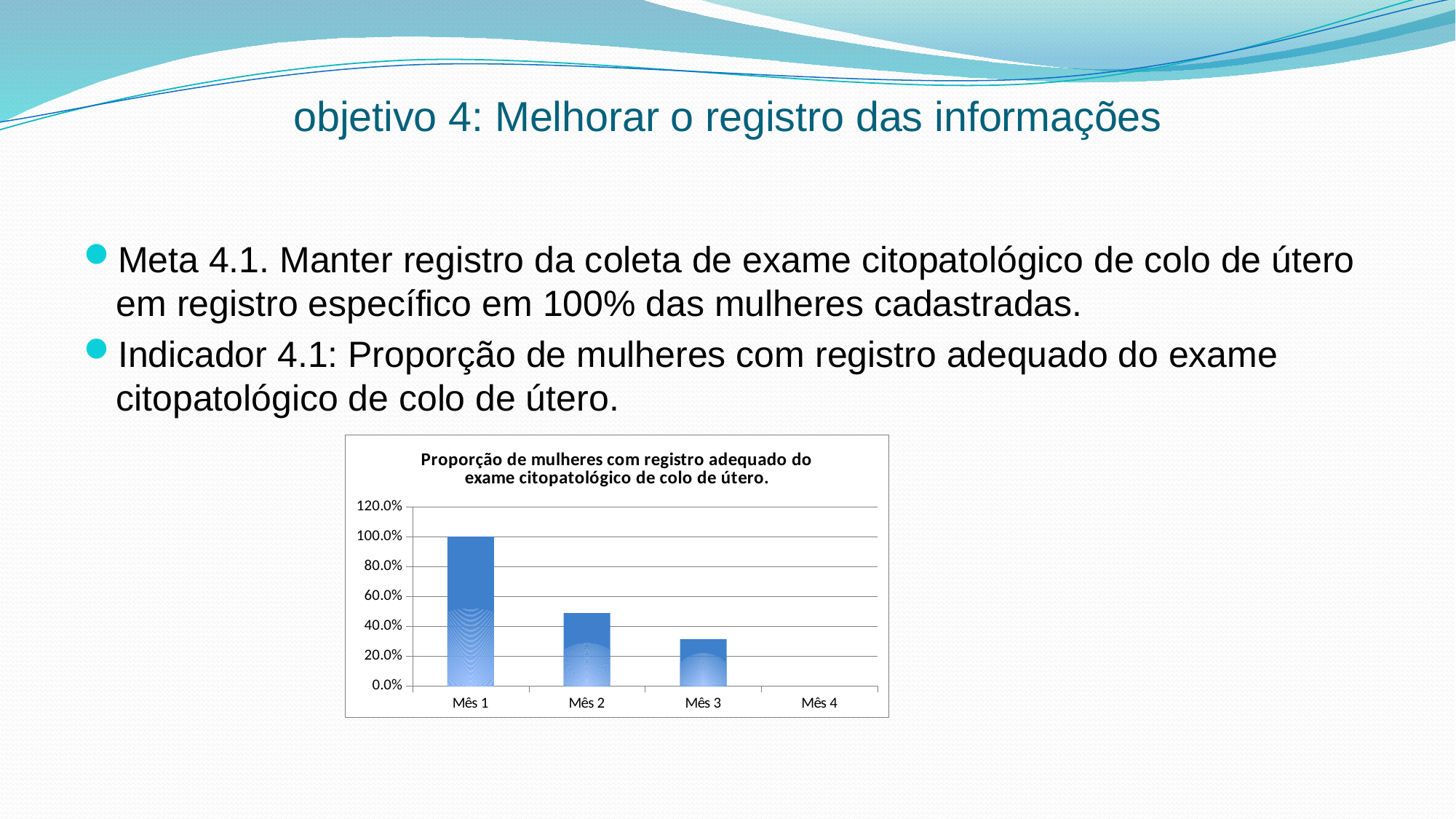
Which month has the highest value? Mês 1 What is the value for Mês 1? 100.0% Which is larger, the value for Mês 2 or the value for Mês 3? Mês 2 Is the value for Mês 2 greater or less than 40.0%? greater Is the value for Mês 3 greater or less than 20.0%? greater Do the values rise or fall from Mês 1 to Mês 4? fall Is the value for Mês 3 greater or less than 40.0%? less What is the title of the chart? Proporção de mulheres com registro adequado do exame citopatológico de colo de útero. How many categories (months) are shown on the x axis of the chart? 4 What kind of chart is shown on the slide? bar chart Which month has the lowest value? Mês 4